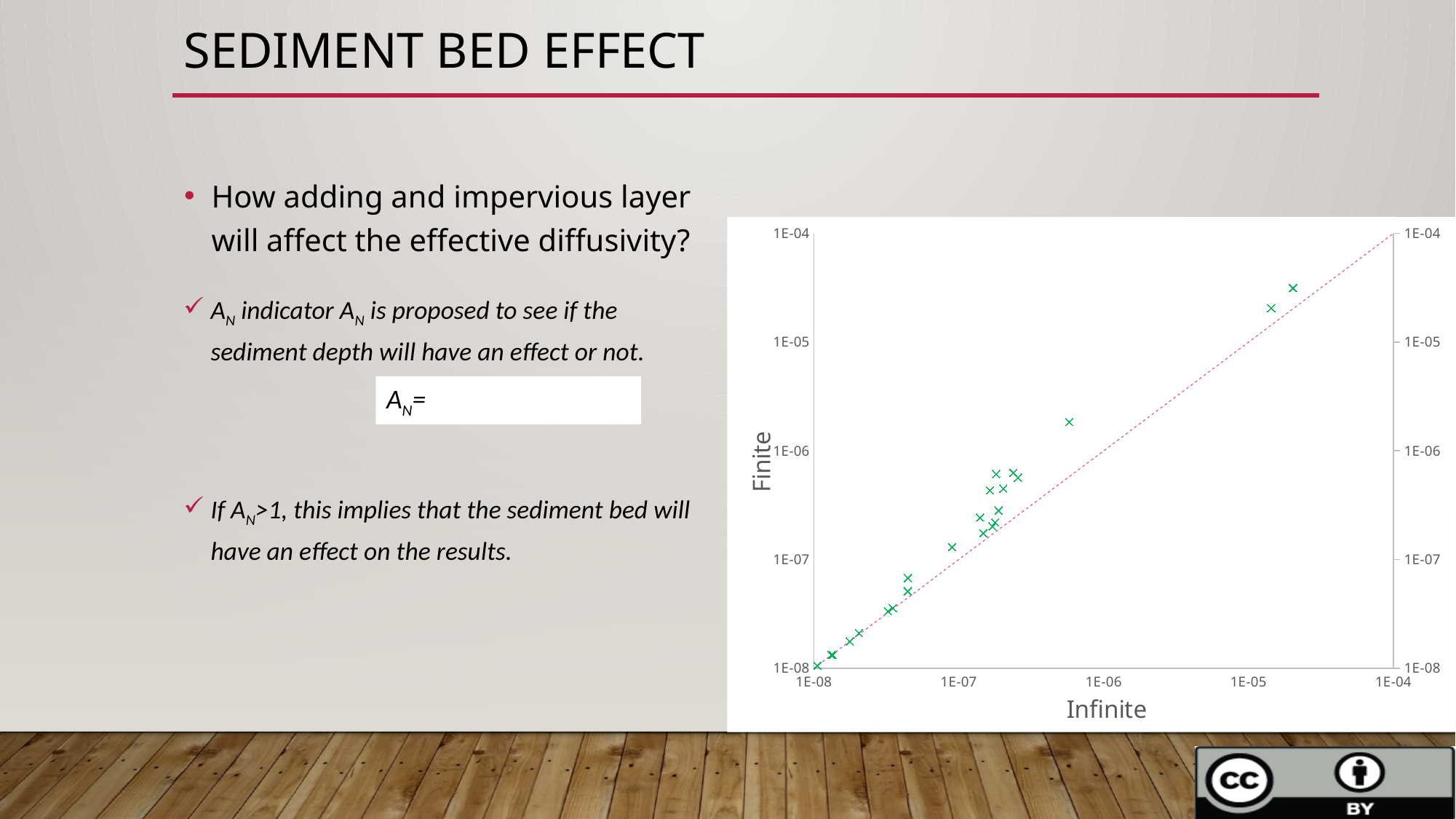
Is the Finite value of the highest plotted point greater or less than 1E-05? greater Is the Finite value of the lowest plotted point greater or less than 1E-07? less What kind of chart is shown on the slide? scatter chart Is the Finite value of the isolated point near Infinite = 1E-06 greater or less than 1E-06? greater Do the Finite values rise or fall as the Infinite values increase along the x axis? rise What is the label of the x axis of the chart? Infinite What is the label of the y axis of the chart? Finite Which is larger for the highest plotted point, its Finite value or its Infinite value? Finite